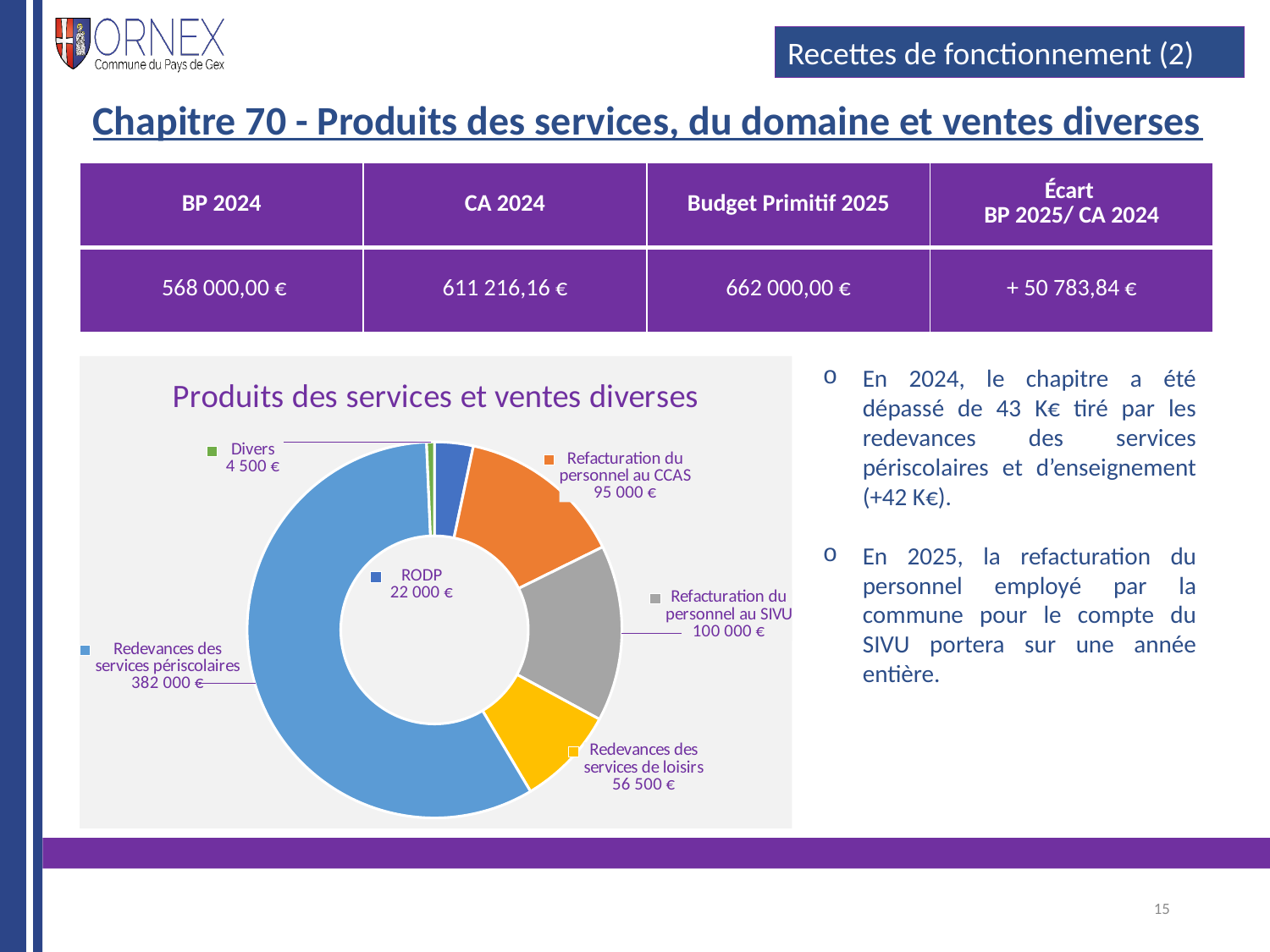
What is the difference between Refacturation du personnel au SIVU and Refacturation du personnel au CCAS? 5 000 € What is the value for Redevances des services périscolaires in the chart? 382 000 € What is the value for Refacturation du personnel au SIVU in the chart? 100 000 € Which category has the smallest value in the chart? Divers What is the value for Refacturation du personnel au CCAS in the chart? 95 000 € Which is larger: Redevances des services de loisirs or RODP? Redevances des services de loisirs What is the title of the chart? Produits des services et ventes diverses How many categories are shown in the chart? 6 What is the value for RODP in the chart? 22 000 € Which category has the largest value in the chart? Redevances des services périscolaires What is the value for Divers in the chart? 4 500 € What kind of chart is shown on the slide? doughnut chart